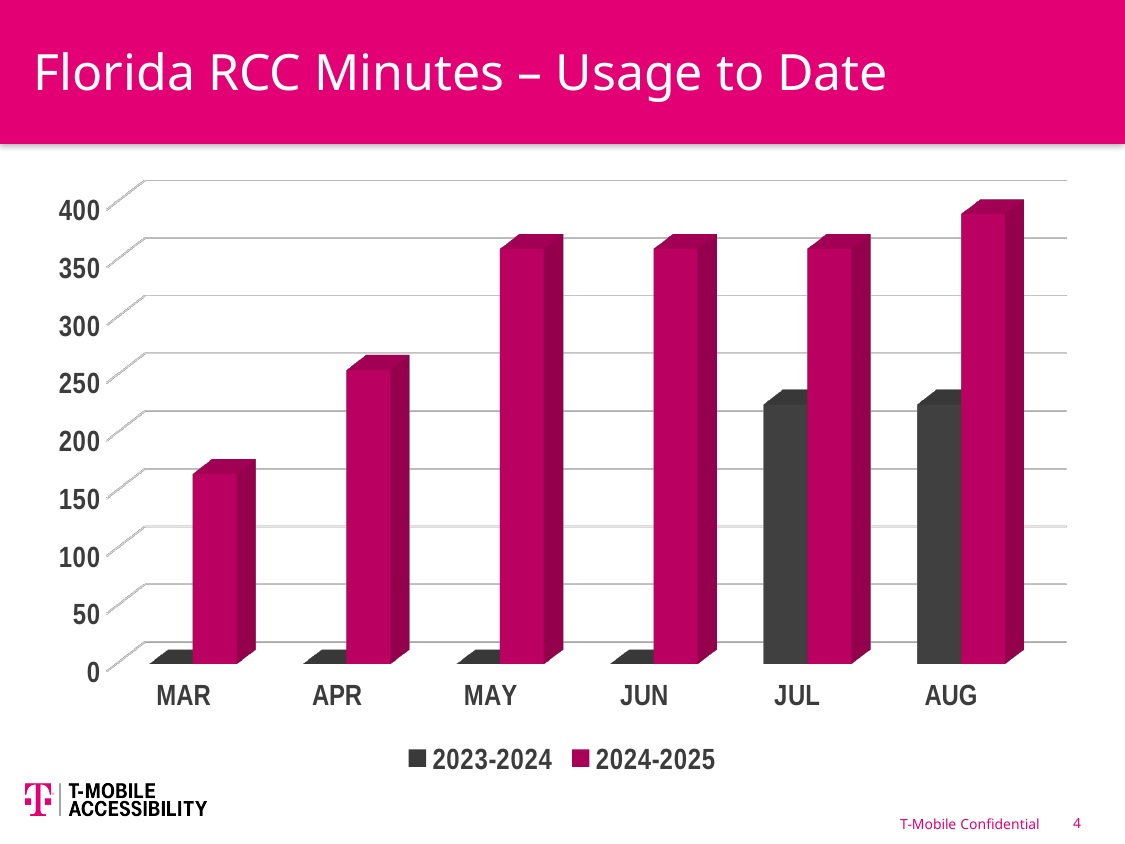
How many months are shown on the x axis of the chart? 6 Is the 2024-2025 value for MAR greater or less than 200? less How many series does the chart's legend list? 2 What is the title of the slide containing the chart? Florida RCC Minutes – Usage to Date What kind of chart is shown on the slide? bar chart Is the 2024-2025 value for APR greater or less than 200? greater In JUL, which series has the larger value: 2023-2024 or 2024-2025? 2024-2025 Is the 2023-2024 value for JUL greater or less than 100? greater Which is larger for 2024-2025: the value for APR or the value for MAY? MAY Which month has the highest value for the 2024-2025 series? AUG Which month has the lowest value for the 2024-2025 series? MAR